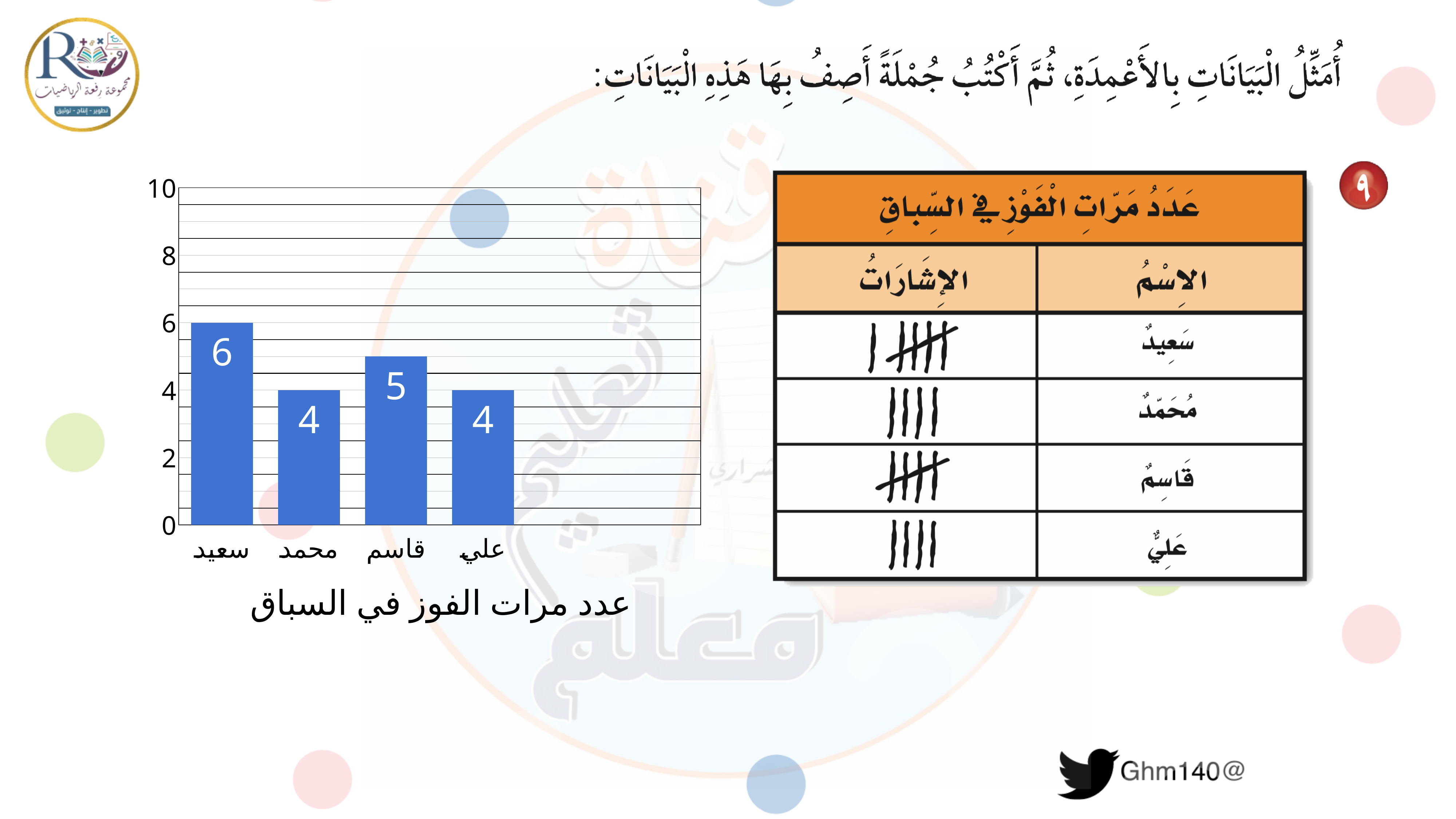
What is the difference between the values for سعيد and محمد? 2 What is the value for سعيد in the chart? 6 What is the value for علي in the chart? 4 Which is larger, the value for قاسم or the value for علي? قاسم What is the maximum value shown on the chart's vertical axis? 10 What is the value for قاسم in the chart? 5 How many bars (categories) does the chart show? 4 What is the title written below the chart? عدد مرات الفوز في السباق Which category has the highest value in the chart? سعيد What is the difference between the values for سعيد and قاسم? 1 What is the value for محمد in the chart? 4 What type of chart is shown on the slide? bar chart